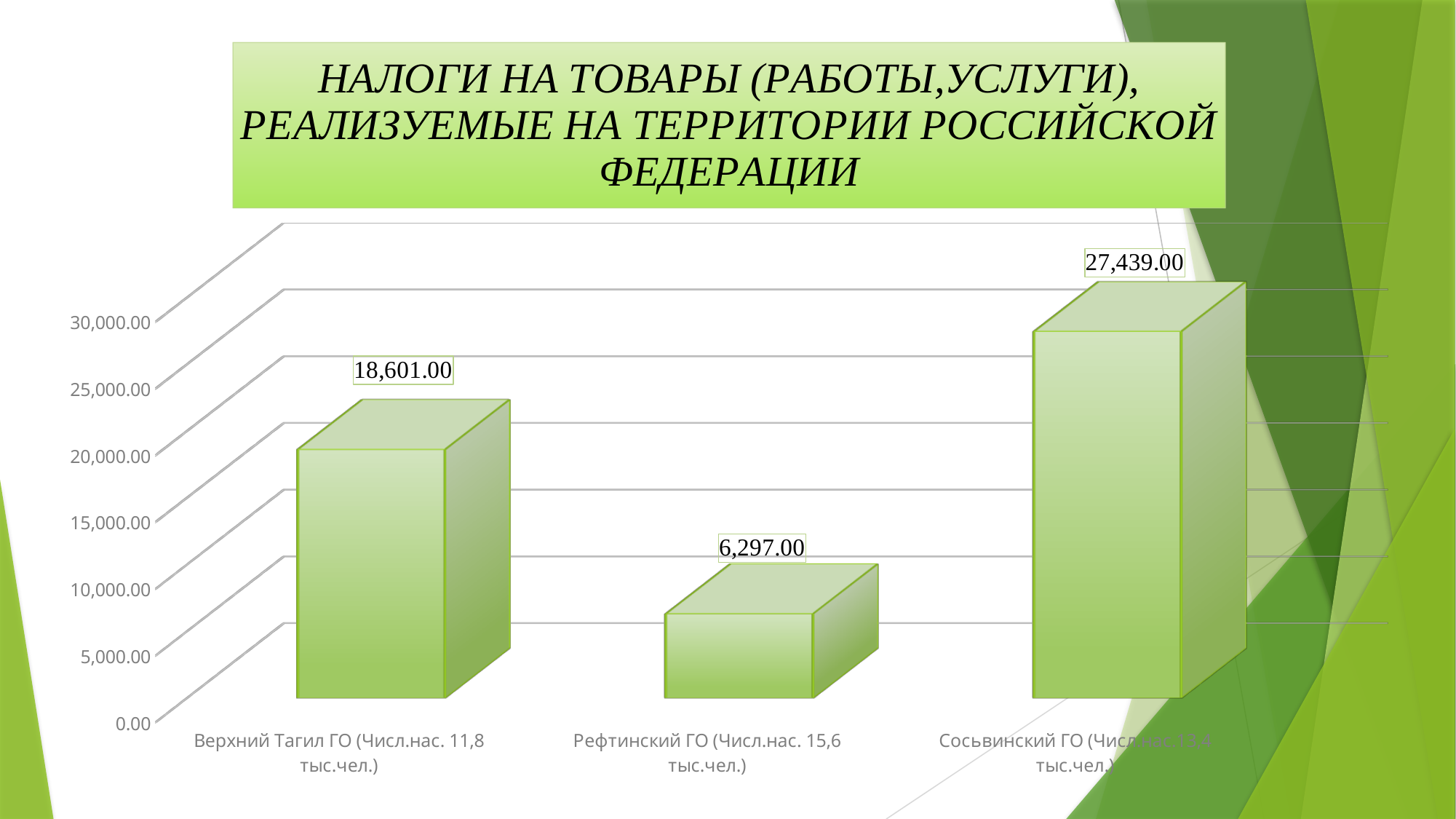
Is the value for Рефтинский ГО greater or less than 10,000.00? less Which category has the lowest value? Рефтинский ГО Which category has the highest value? Сосьвинский ГО What kind of chart is shown on the slide? bar chart Which is larger, the value for Верхний Тагил ГО or the value for Рефтинский ГО? Верхний Тагил ГО What is the value for Верхний Тагил ГО? 18,601.00 What is the difference between the values for Верхний Тагил ГО and Рефтинский ГО? 12,304.00 What is the value for Рефтинский ГО? 6,297.00 What is the difference between the values for Сосьвинский ГО and Верхний Тагил ГО? 8,838.00 How many categories are shown in the chart? 3 What is the title of the chart? НАЛОГИ НА ТОВАРЫ (РАБОТЫ,УСЛУГИ), РЕАЛИЗУЕМЫЕ НА ТЕРРИТОРИИ РОССИЙСКОЙ ФЕДЕРАЦИИ What is the value for Сосьвинский ГО? 27,439.00